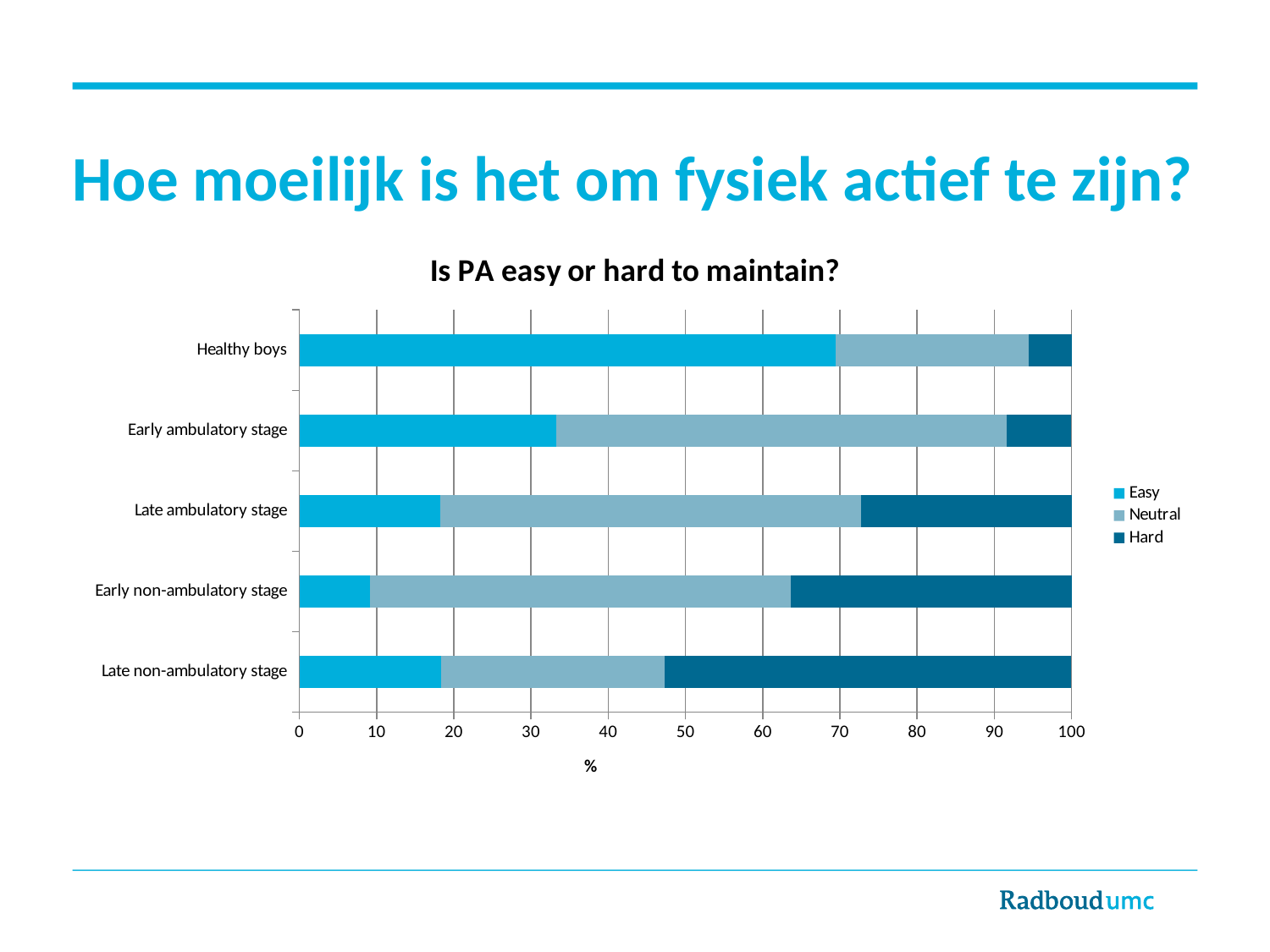
How many categories (groups) are shown on the y axis of the chart? 5 What is the total of the stacked bar for Late ambulatory stage? 100 Is the Easy value for Healthy boys greater or less than 60? greater How many series does the legend list? 3 What is the title of the chart? Is PA easy or hard to maintain? Which group has the largest Hard share? Late non-ambulatory stage Which group has the smallest Easy share? Early non-ambulatory stage What kind of chart is shown on the slide? stacked bar chart Which has a larger Easy share: Healthy boys or Early ambulatory stage? Healthy boys Is the Hard value for Late non-ambulatory stage greater or less than 40? greater Is the Easy value for Early ambulatory stage greater or less than 40? less Which group has the largest Easy share? Healthy boys